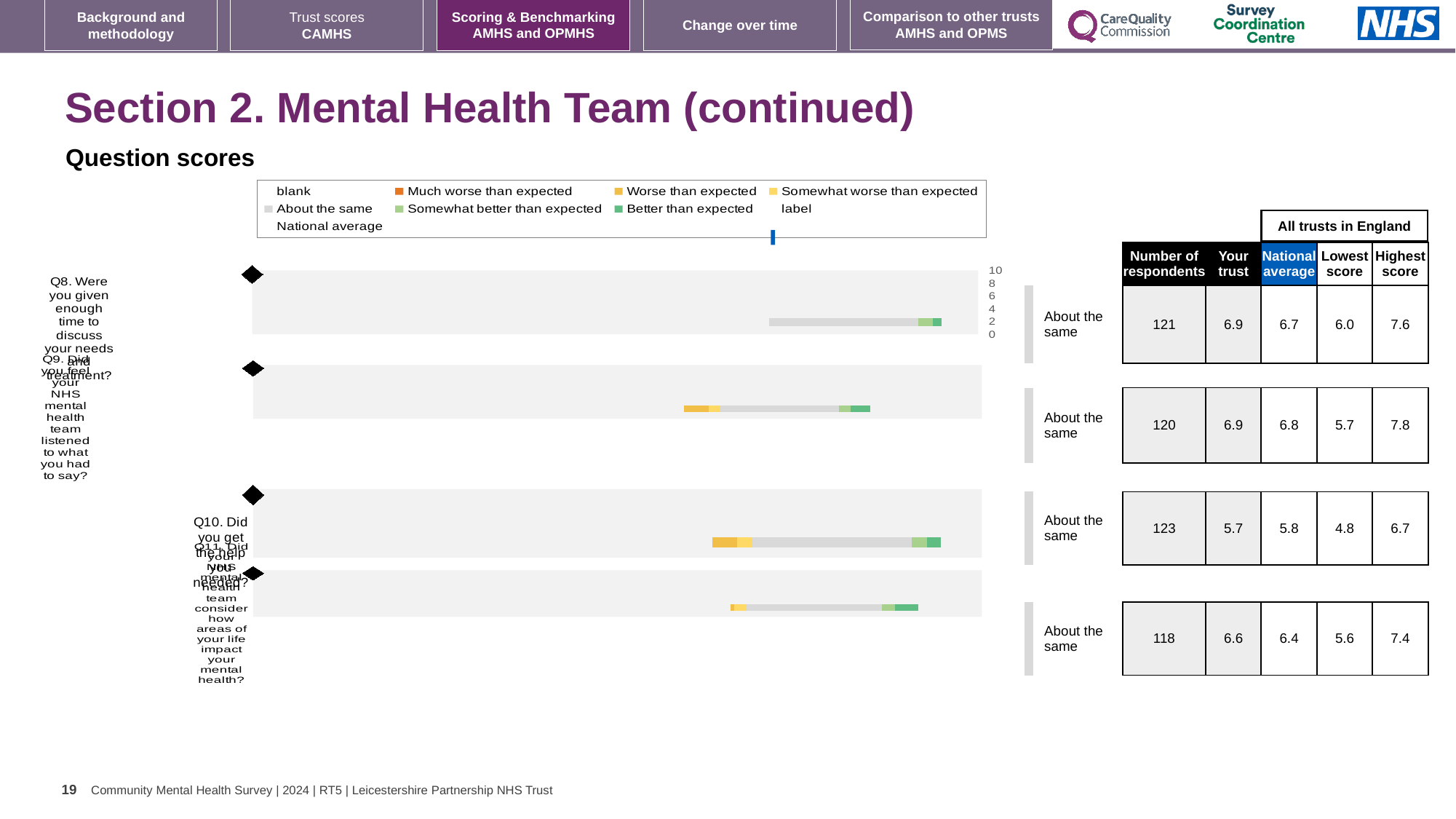
In the table beside the chart, what is the difference between the highest score and the lowest score for Q8? 1.6 In the question scores chart legend, what colour represents 'Better than expected'? green In the table beside the chart, which question has the highest number of respondents? Q10 In the table beside the chart, what is the highest score for Q9? 7.8 What kind of chart is used to show the question scores? bar chart How many questions (categories) are plotted in the question scores chart? 4 In the table beside the chart, what is the 'Your trust' score for Q10? 5.7 In the table beside the chart, is the 'Your trust' score for Q9 higher or lower than the national average? higher In the table beside the chart, what is the number of respondents for Q8? 121 In the question scores chart legend, what colour represents 'Much worse than expected'? orange In the table beside the chart, what is the national average for Q11? 6.4 In the table beside the chart, which question has the lowest 'Your trust' score? Q10